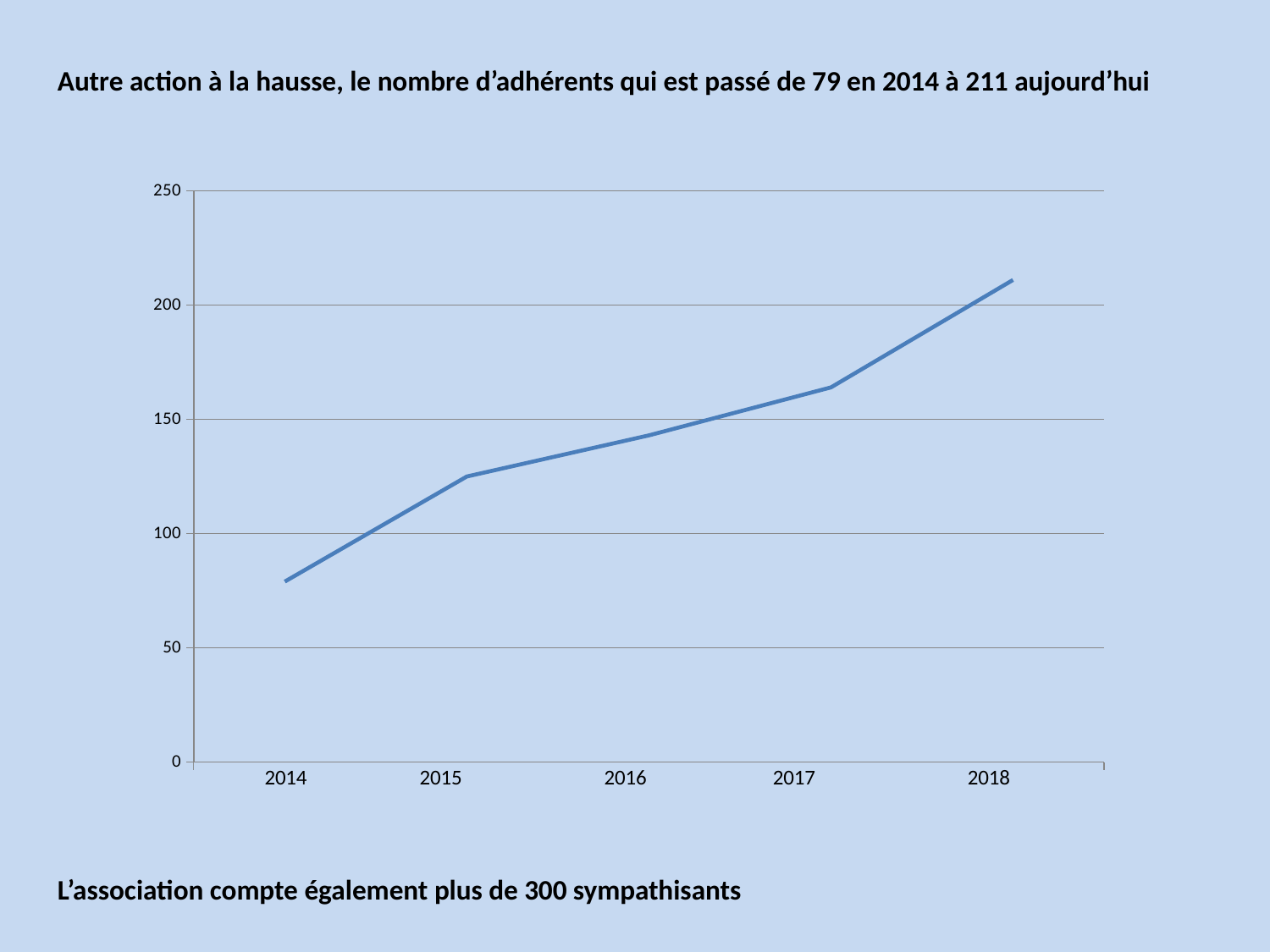
Is the value for 2017 greater or less than 150? greater According to the slide, what was the number of adhérents in 2014? 79 Which year has the larger value, 2015 or 2017? 2017 How many years are plotted on the x axis of the chart? 5 Is the value for 2016 greater or less than 150? less Do the values rise or fall from 2014 to 2018? rise Which year has the highest number of adhérents? 2018 According to the slide, what is the number of adhérents in 2018 (aujourd'hui)? 211 Which year has the lowest number of adhérents? 2014 By how much did the number of adhérents increase between 2014 and 2018? 132 Is the value for 2015 greater or less than 100? greater What type of chart is shown on the slide? line chart